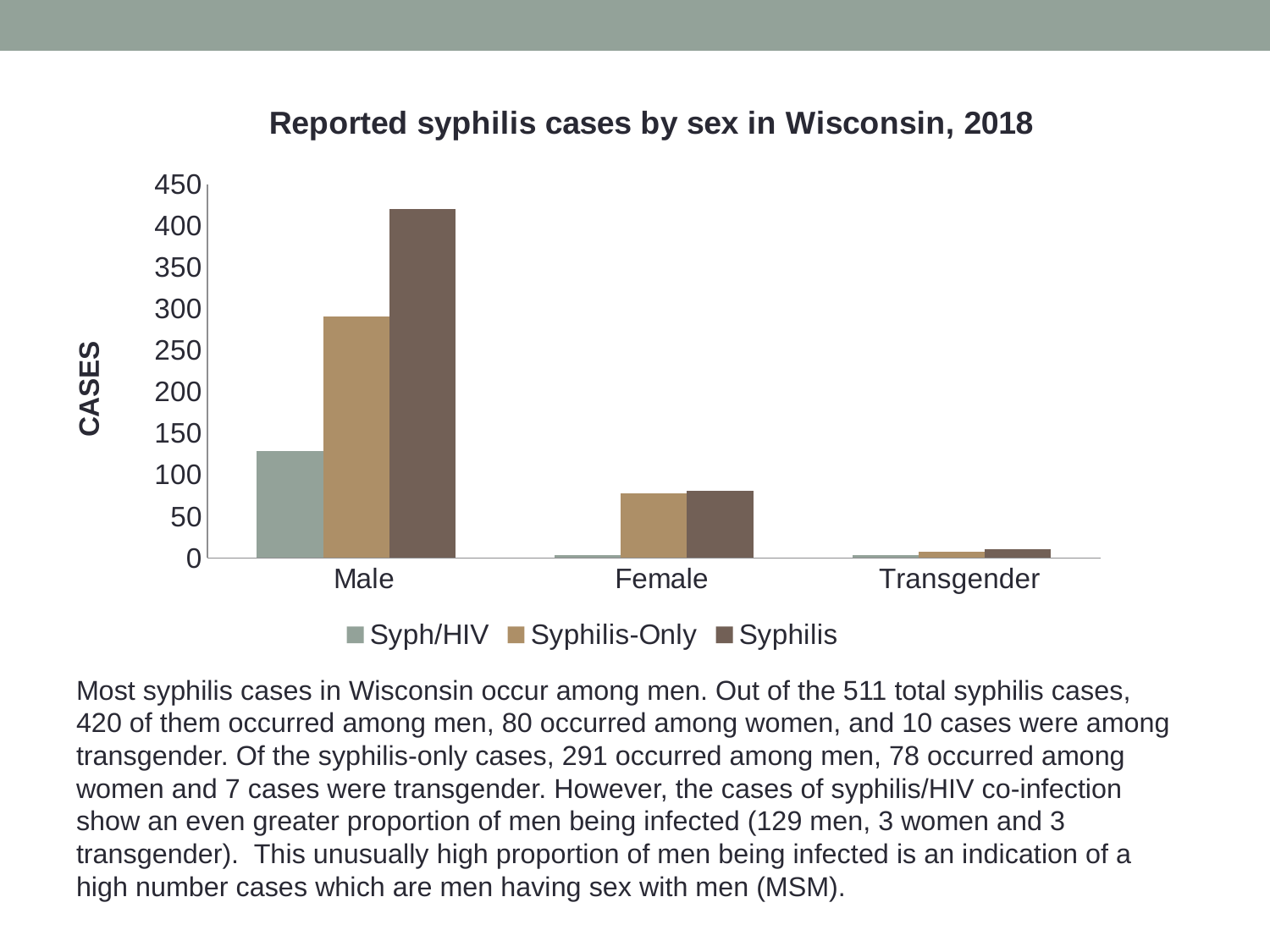
According to the slide, how many Syphilis cases occurred among men? 420 Which category has the lowest Syphilis-Only value? Transgender Is the Syphilis-Only value for Female greater or less than 100? less Is the Syph/HIV value for Male greater or less than 100? greater How many categories are shown on the x axis? 3 What kind of chart is shown on the slide? bar chart According to the slide, how many Syphilis-Only cases occurred among women? 78 Which is larger for Male: the Syphilis-Only value or the Syph/HIV value? Syphilis-Only What is the title of the chart? Reported syphilis cases by sex in Wisconsin, 2018 Is the Syphilis value for Male greater or less than 400? greater How many series does the legend list? 3 Which category has the highest Syphilis value? Male